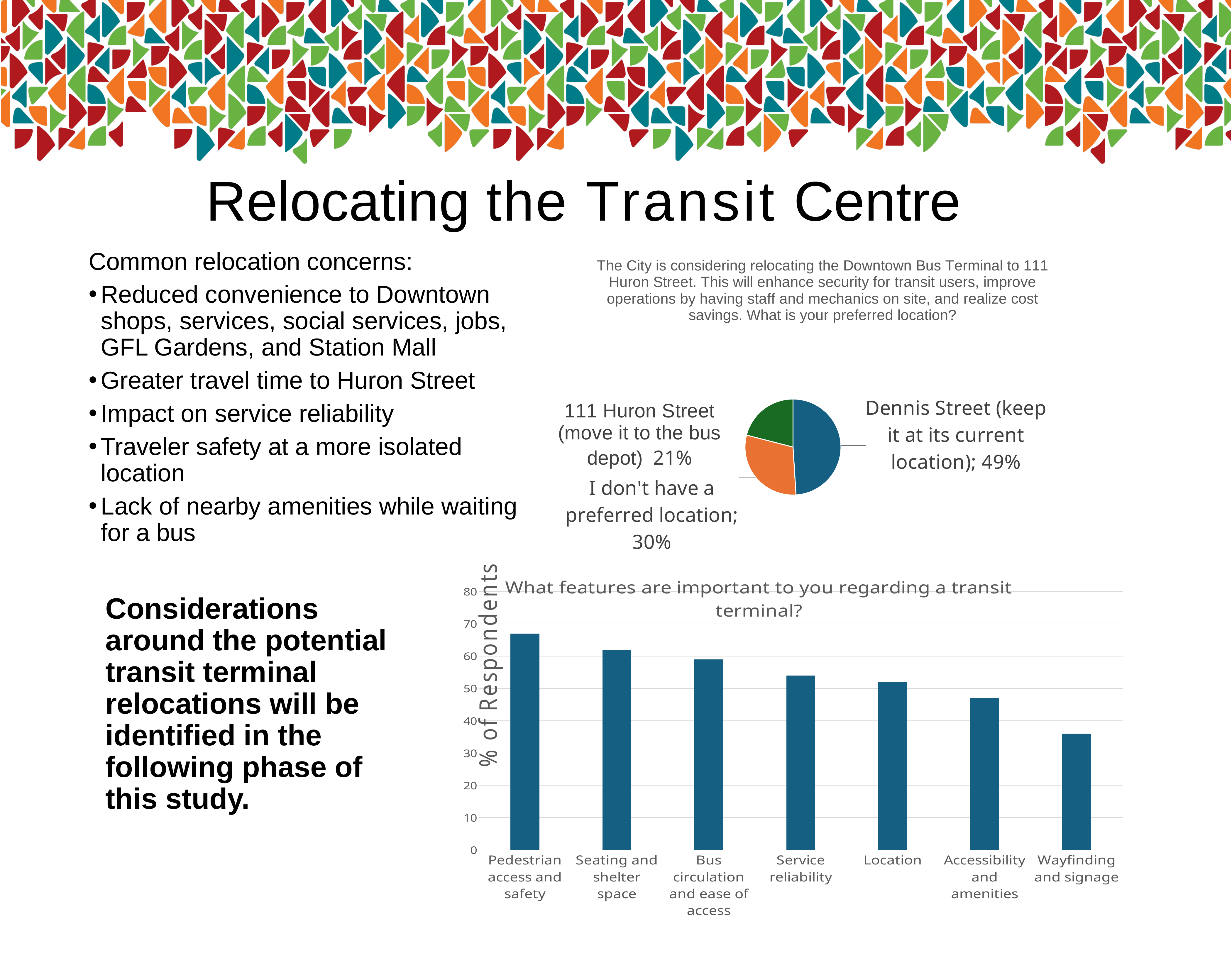
In the chart 'What features are important to you regarding a transit terminal?', which feature has the lowest percentage of respondents? Wayfinding and signage In the chart 'What features are important to you regarding a transit terminal?', do the bar values rise or fall from left to right? fall In the chart 'What features are important to you regarding a transit terminal?', is the value for Wayfinding and signage greater or less than 40? less In the pie chart about the preferred location, what share of respondents chose Dennis Street (keep it at its current location)? 49% In the pie chart about the preferred location, what share of respondents said they don't have a preferred location? 30% What kind of chart is the chart titled 'What features are important to you regarding a transit terminal?'? bar chart In the chart 'What features are important to you regarding a transit terminal?', which feature has the highest percentage of respondents? Pedestrian access and safety In the pie chart about the preferred location, what share of respondents chose 111 Huron Street (move it to the bus depot)? 21% In the pie chart about the preferred location, which option has the largest share? Dennis Street (keep it at its current location) In the chart 'What features are important to you regarding a transit terminal?', how many features are shown on the x axis? 7 In the pie chart about the preferred location, what is the difference in percentage points between Dennis Street and 111 Huron Street? 28 How many slices does the pie chart about the preferred location have? 3